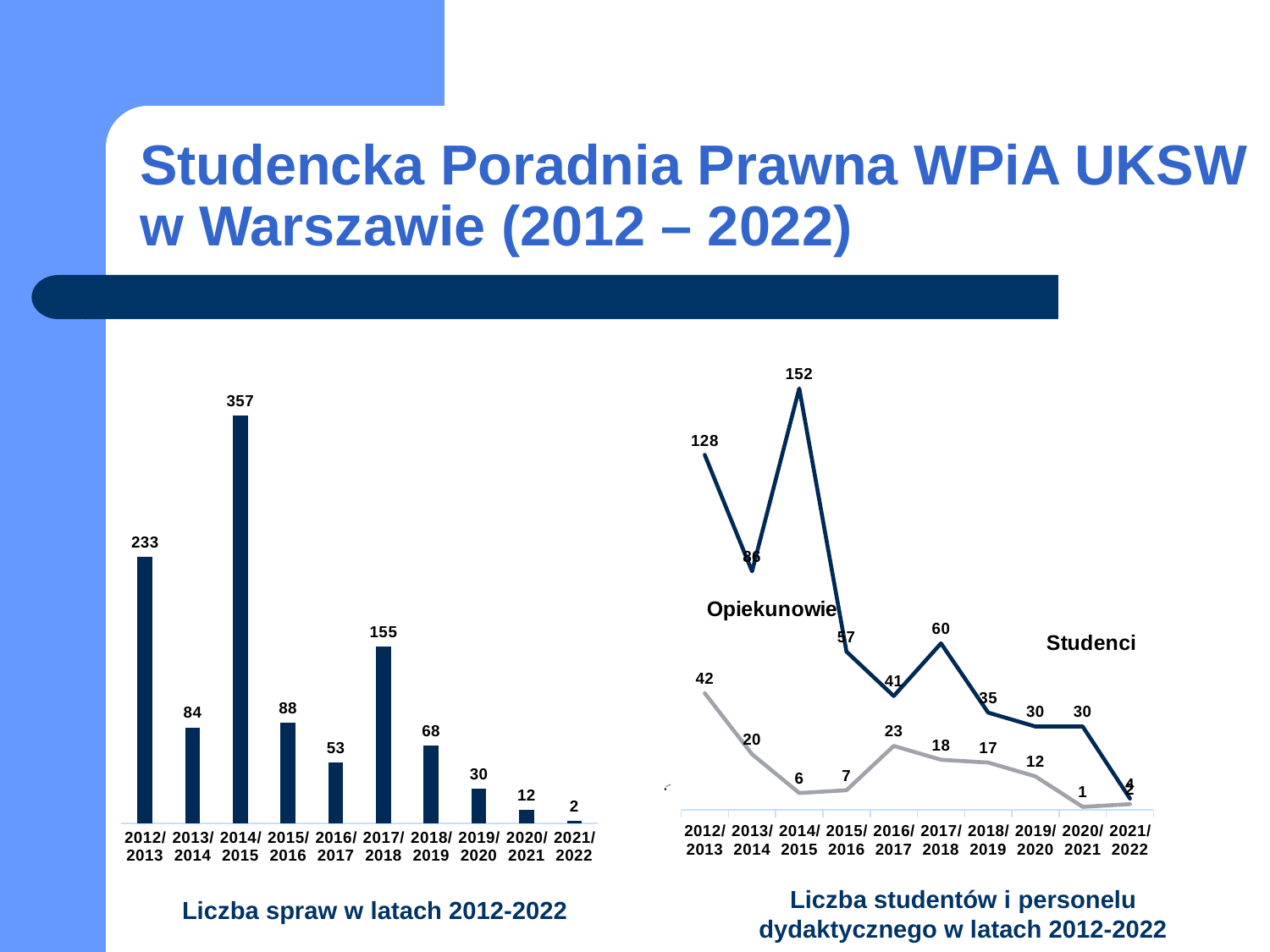
On the left chart (Liczba spraw w latach 2012-2022), what is the difference between the values for 2012/2013 and 2013/2014? 149 On the left chart (Liczba spraw w latach 2012-2022), which is larger, the value for 2015/2016 or the value for 2018/2019? 2015/2016 On the left chart (Liczba spraw w latach 2012-2022), what is the value for 2014/2015? 357 What kind of chart is the right chart (Liczba studentów i personelu dydaktycznego)? line chart On the right chart (Liczba studentów i personelu dydaktycznego), what is the difference between the dark blue line and the grey line for 2012/2013? 86 On the left chart (Liczba spraw w latach 2012-2022), how many years are shown on the x axis? 10 On the left chart (Liczba spraw w latach 2012-2022), which year has the highest value? 2014/2015 On the right chart (Liczba studentów i personelu dydaktycznego), what is the value of the grey line for 2016/2017? 23 On the left chart (Liczba spraw w latach 2012-2022), which year has the lowest value? 2021/2022 What kind of chart is the left chart (Liczba spraw w latach 2012-2022)? bar chart On the left chart (Liczba spraw w latach 2012-2022), what is the value for 2017/2018? 155 On the right chart (Liczba studentów i personelu dydaktycznego), what is the value of the dark blue line for 2014/2015? 152